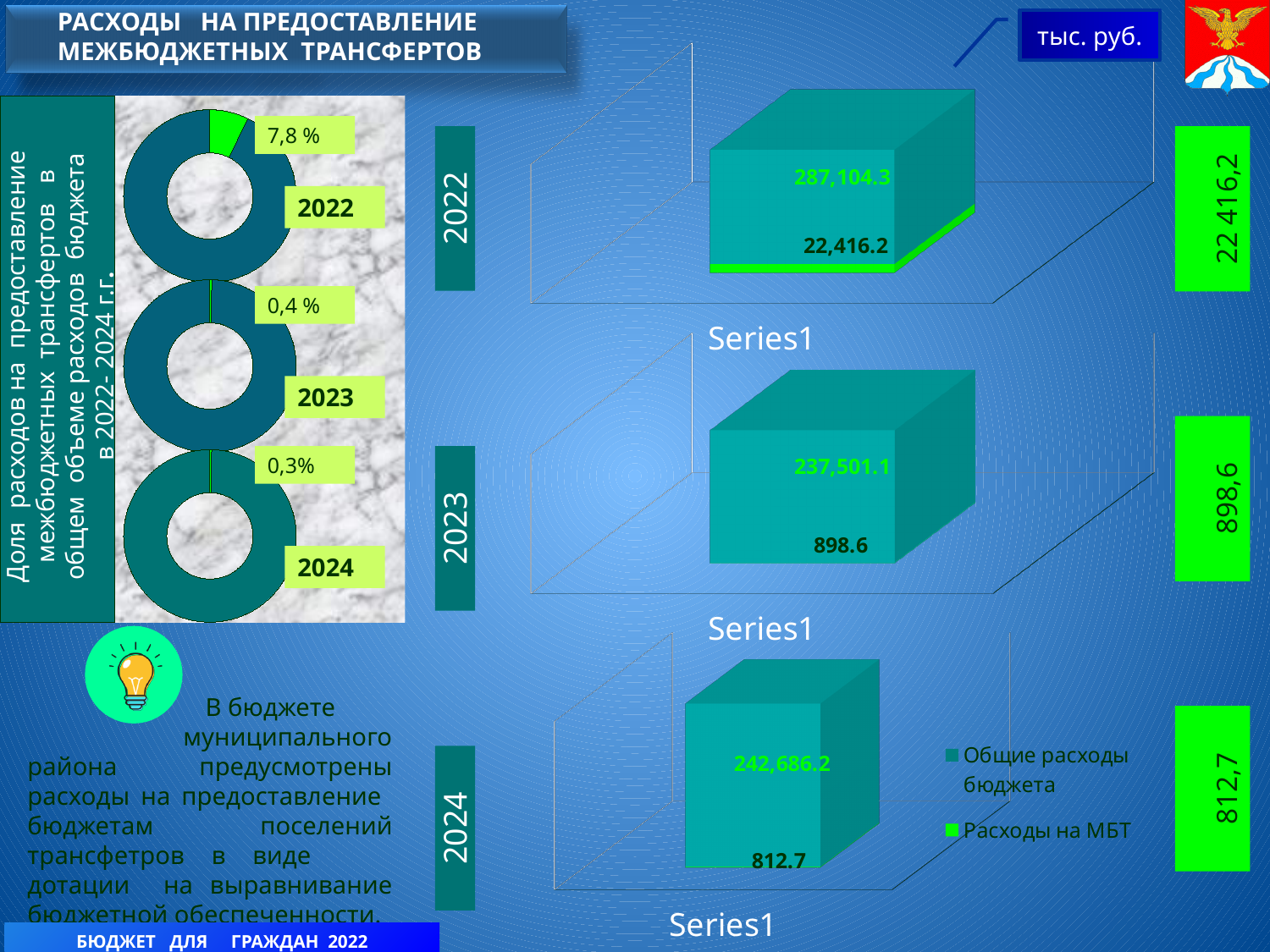
In the 2022 bar chart, what is the difference between Общие расходы бюджета and Расходы на МБТ? 264,688.1 In the 2023 donut chart, what share do expenses on intergovernmental transfers (МБТ) make up? 0,4 % In the 2024 bar chart, what is the value for Расходы на МБТ? 812.7 Which is larger: Расходы на МБТ in the 2022 bar chart or in the 2023 bar chart? 2022 (22,416.2) In the 2022 bar chart, what is the value for Расходы на МБТ? 22,416.2 How many series does the legend of the bar charts list? 2 In the 2022 bar chart, what is the value for Общие расходы бюджета? 287,104.3 Among the three donut charts (2022, 2023, 2024), which year shows the lowest share of МБТ expenses? 2024 What unit of measurement is indicated for the bar charts on the slide? тыс. руб. What kind of chart is used to show the 2024 budget expenses on the right side of the slide? Bar chart In the 2023 bar chart, what is the value for Общие расходы бюджета? 237,501.1 Among the three donut charts (2022, 2023, 2024), which year shows the highest share of МБТ expenses? 2022